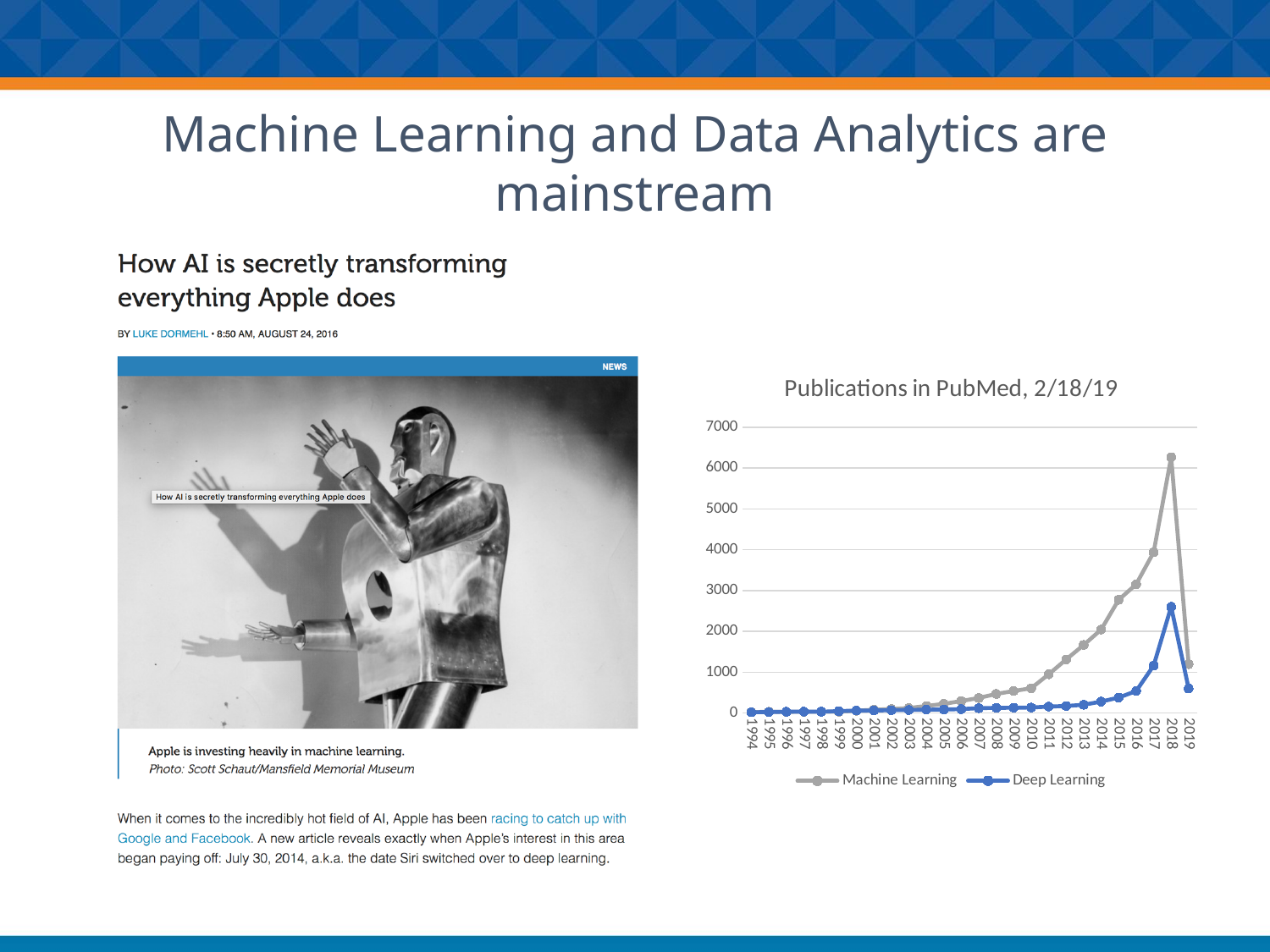
Which series has the larger value in 2018, Machine Learning or Deep Learning? Machine Learning Is the Machine Learning value for 2018 greater or less than 6000? greater How many series does the chart's legend list? 2 What is the title of the chart on the slide? Publications in PubMed, 2/18/19 In which year does the Machine Learning series reach its highest value? 2018 Which series is drawn in blue in the chart? Deep Learning How many years are plotted along the x axis of the chart? 26 What kind of chart is shown on the slide? line chart Is the Deep Learning value for 2019 greater or less than 1000? less Is the Deep Learning value for 2018 greater or less than 3000? less In which year does the Deep Learning series reach its highest value? 2018 Does the Machine Learning series rise or fall between 2010 and 2018? rise